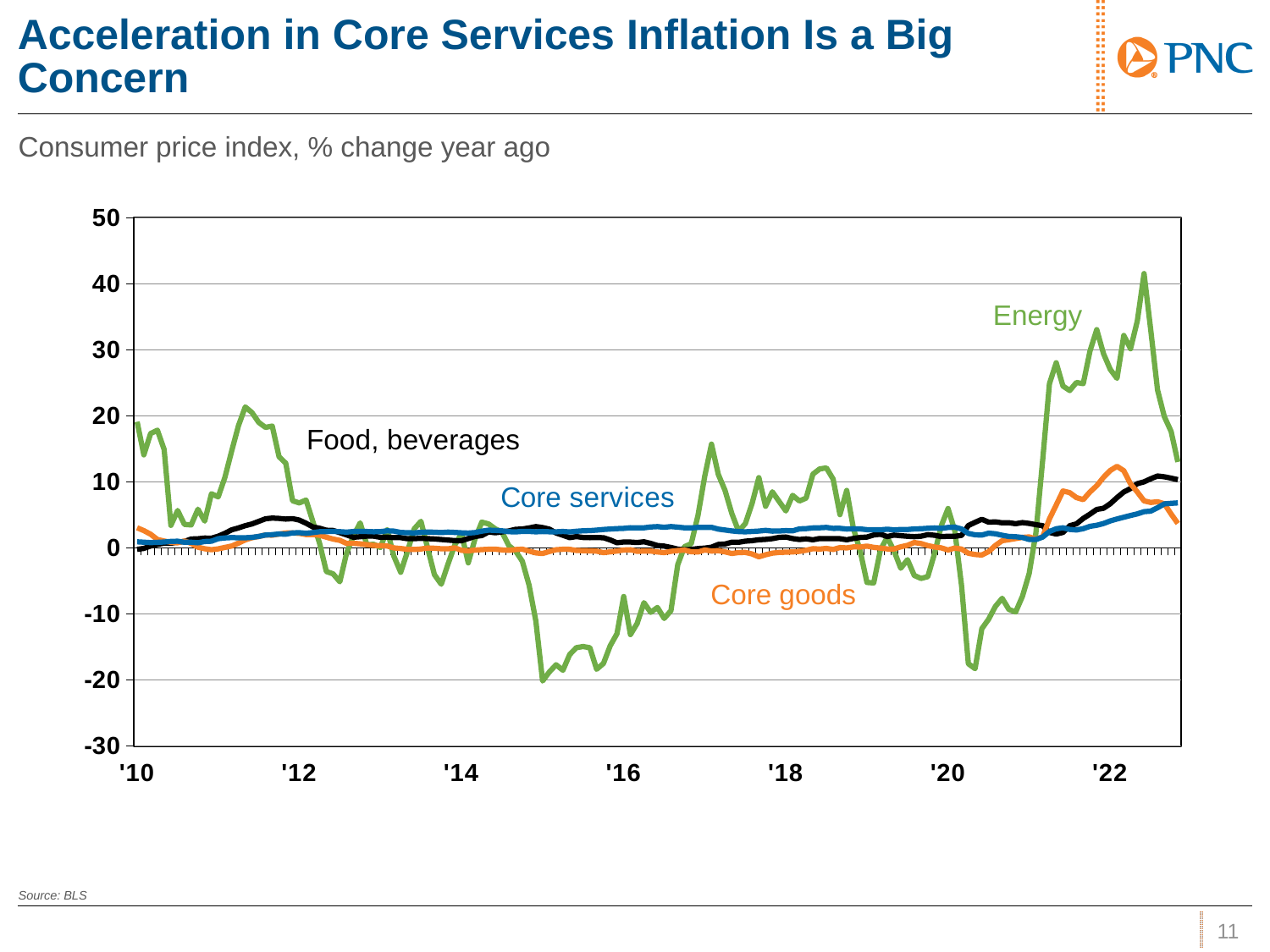
Is the peak value for Food, beverages in 2022 greater or less than 5? greater Is the value for Core services at the end of 2022 greater or less than 5? greater Which series reaches the highest value on the chart? Energy At the end of 2022, which is higher: Energy or Core services? Energy What is the highest value shown on the vertical axis? 50 What kind of chart is shown on the slide? Line chart Does the Core services line rise or fall between 2020 and 2022? Rise Is the lowest value for Energy around 2015 greater or less than -10? less What is the subtitle describing the data on the chart? Consumer price index, % change year ago Which series reaches the lowest value on the chart? Energy How many series are plotted on the chart? 4